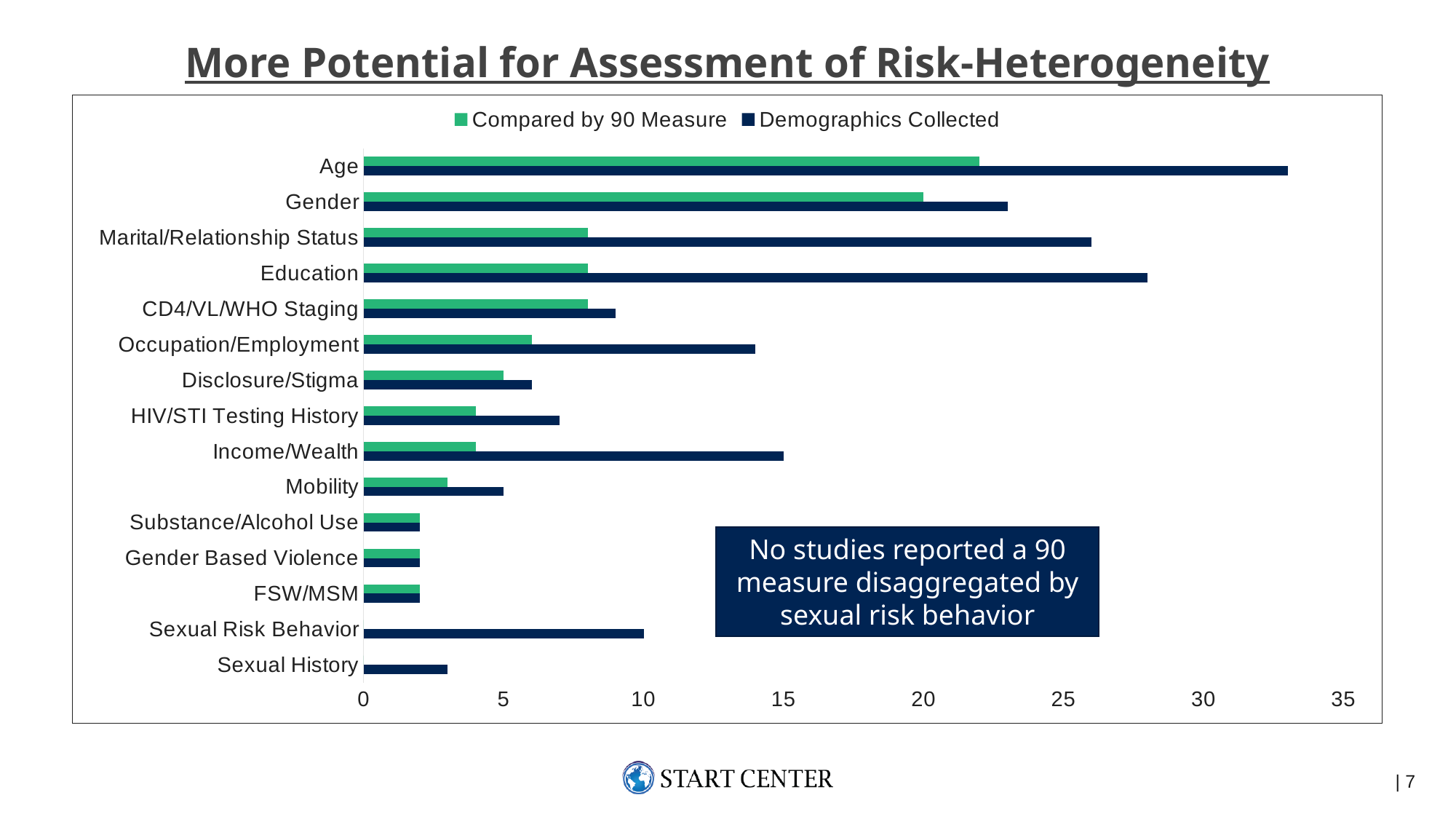
How many categories are plotted on the chart? 15 Is the Compared by 90 Measure value for Age greater or less than 20? greater How many series does the legend list? 2 What are the two series named in the legend? Compared by 90 Measure and Demographics Collected Is the Demographics Collected value for Occupation/Employment greater or less than 15? less Which category has the highest Compared by 90 Measure value? Age Which category has the highest Demographics Collected value? Age What is the Demographics Collected value for Sexual Risk Behavior? 10 Is the Demographics Collected value for Education greater or less than 25? greater What kind of chart is shown on the slide? bar chart Which has a larger Demographics Collected value, Income/Wealth or HIV/STI Testing History? Income/Wealth